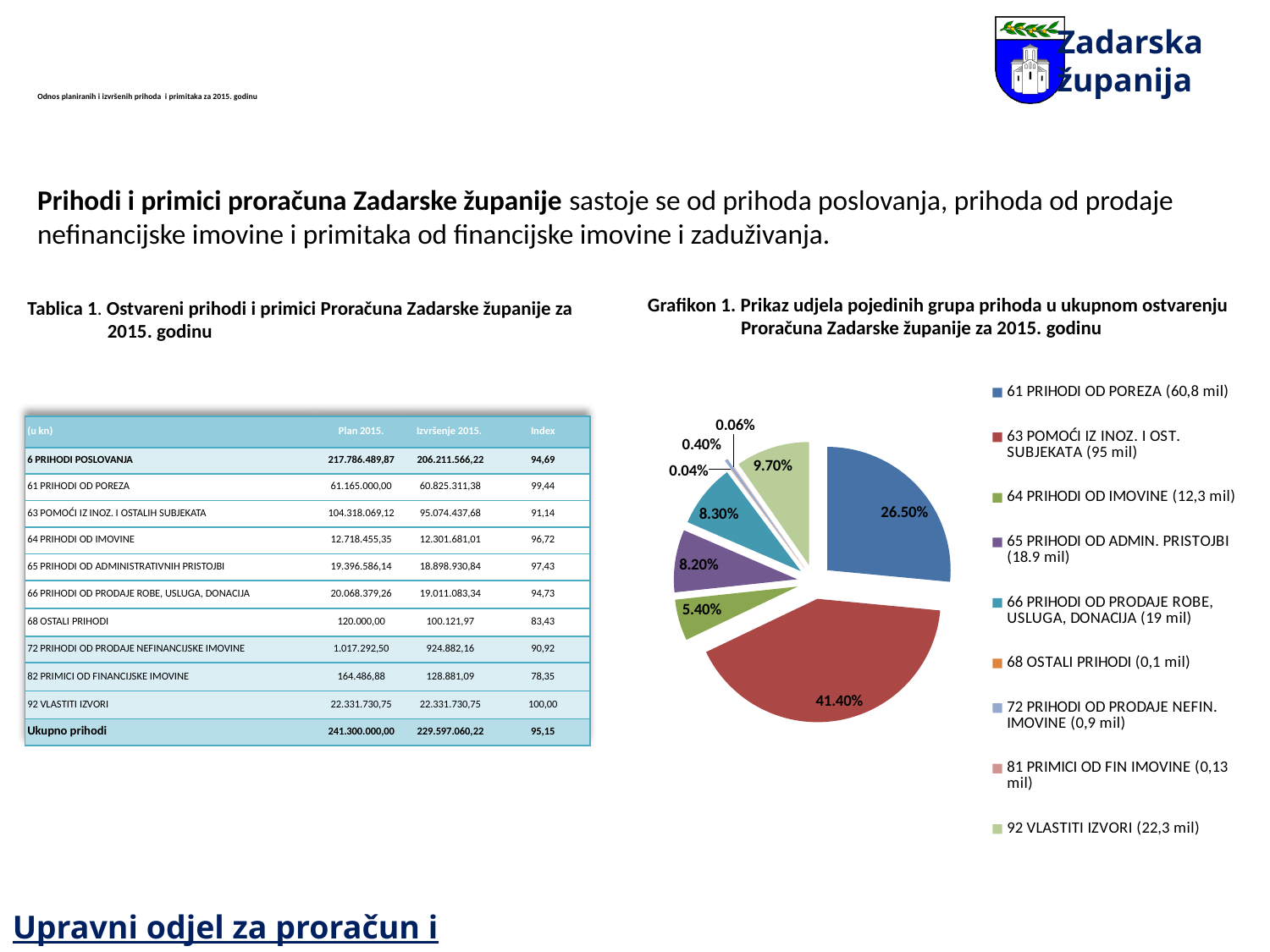
In Grafikon 1, which slice is larger: 92 VLASTITI IZVORI or 64 PRIHODI OD IMOVINE? 92 VLASTITI IZVORI How many categories does the legend of Grafikon 1 list? 9 In Grafikon 1, what is the difference in percentage points between the slice for 63 POMOĆI IZ INOZ. I OST. SUBJEKATA and the slice for 61 PRIHODI OD POREZA? 14.90% In Grafikon 1, what percentage is shown for 65 PRIHODI OD ADMIN. PRISTOJBI? 8.20% In Grafikon 1, what percentage is shown for 63 POMOĆI IZ INOZ. I OST. SUBJEKATA? 41.40% In Grafikon 1, what percentage is shown for 64 PRIHODI OD IMOVINE? 5.40% In Grafikon 1, what share of the pie is labelled for 61 PRIHODI OD POREZA? 26.50% Which category has the largest slice in Grafikon 1? 63 POMOĆI IZ INOZ. I OST. SUBJEKATA What is the title of the pie chart on the slide? Grafikon 1. Prikaz udjela pojedinih grupa prihoda u ukupnom ostvarenju Proračuna Zadarske županije za 2015. godinu In Grafikon 1, what percentage is shown for 92 VLASTITI IZVORI? 9.70% Which category has the smallest slice in Grafikon 1? 68 OSTALI PRIHODI What kind of chart is Grafikon 1? pie chart